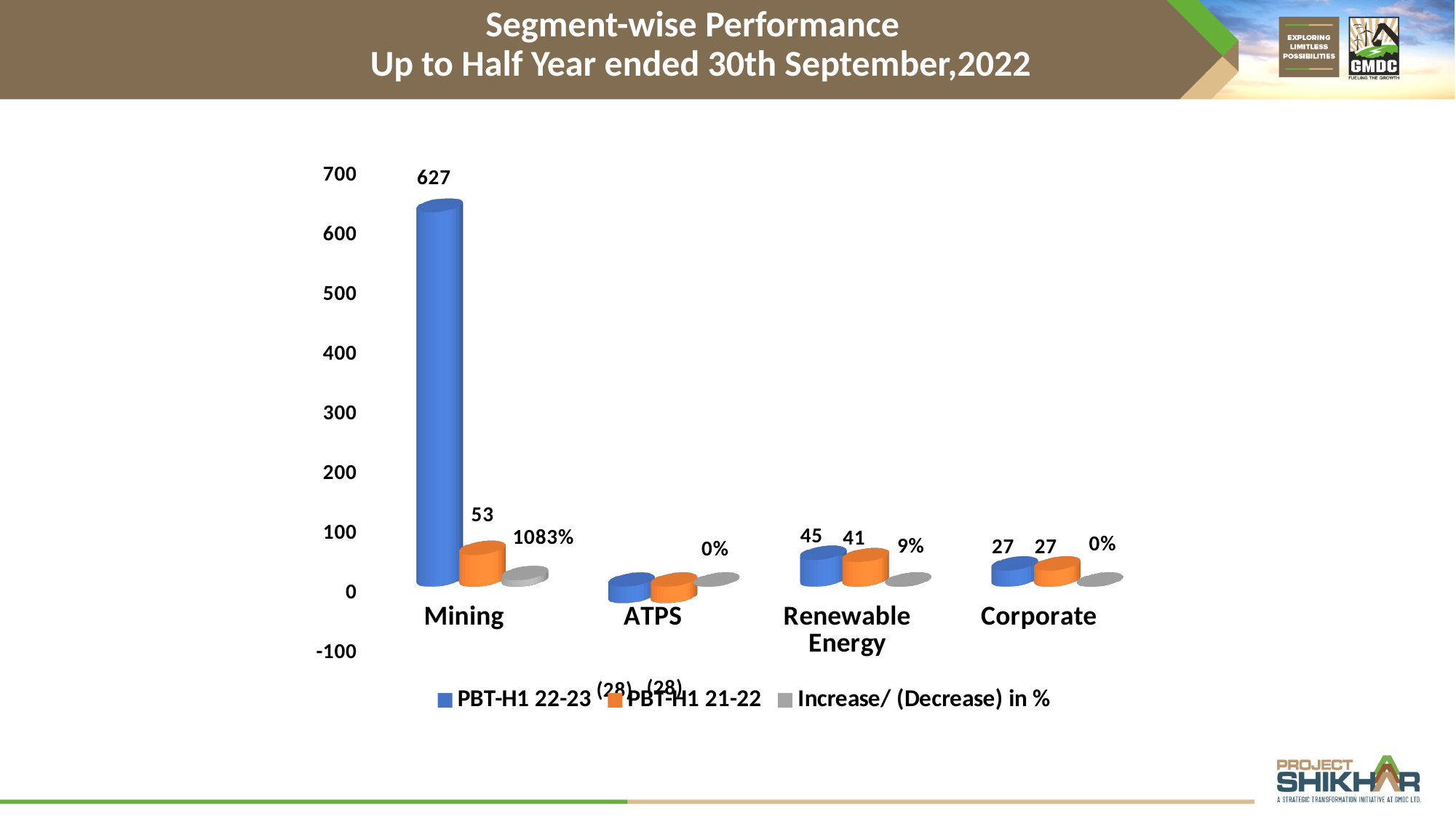
Which segment has the lowest PBT-H1 22-23 value? ATPS What is the Increase/ (Decrease) in % for Renewable Energy? 9% What is the PBT-H1 22-23 value for Renewable Energy? 45 Which segment has the highest PBT-H1 22-23 value? Mining How many segments are shown on the x axis of the chart? 4 What is the Increase/ (Decrease) in % for Mining? 1083% What is the PBT-H1 21-22 value for Mining? 53 What is the difference between the PBT-H1 22-23 and PBT-H1 21-22 values for Mining? 574 Which is larger for Renewable Energy, the PBT-H1 22-23 value or the PBT-H1 21-22 value? PBT-H1 22-23 What is the PBT-H1 21-22 value for Corporate? 27 What is the PBT-H1 22-23 value for Mining? 627 How many series does the chart legend list? 3